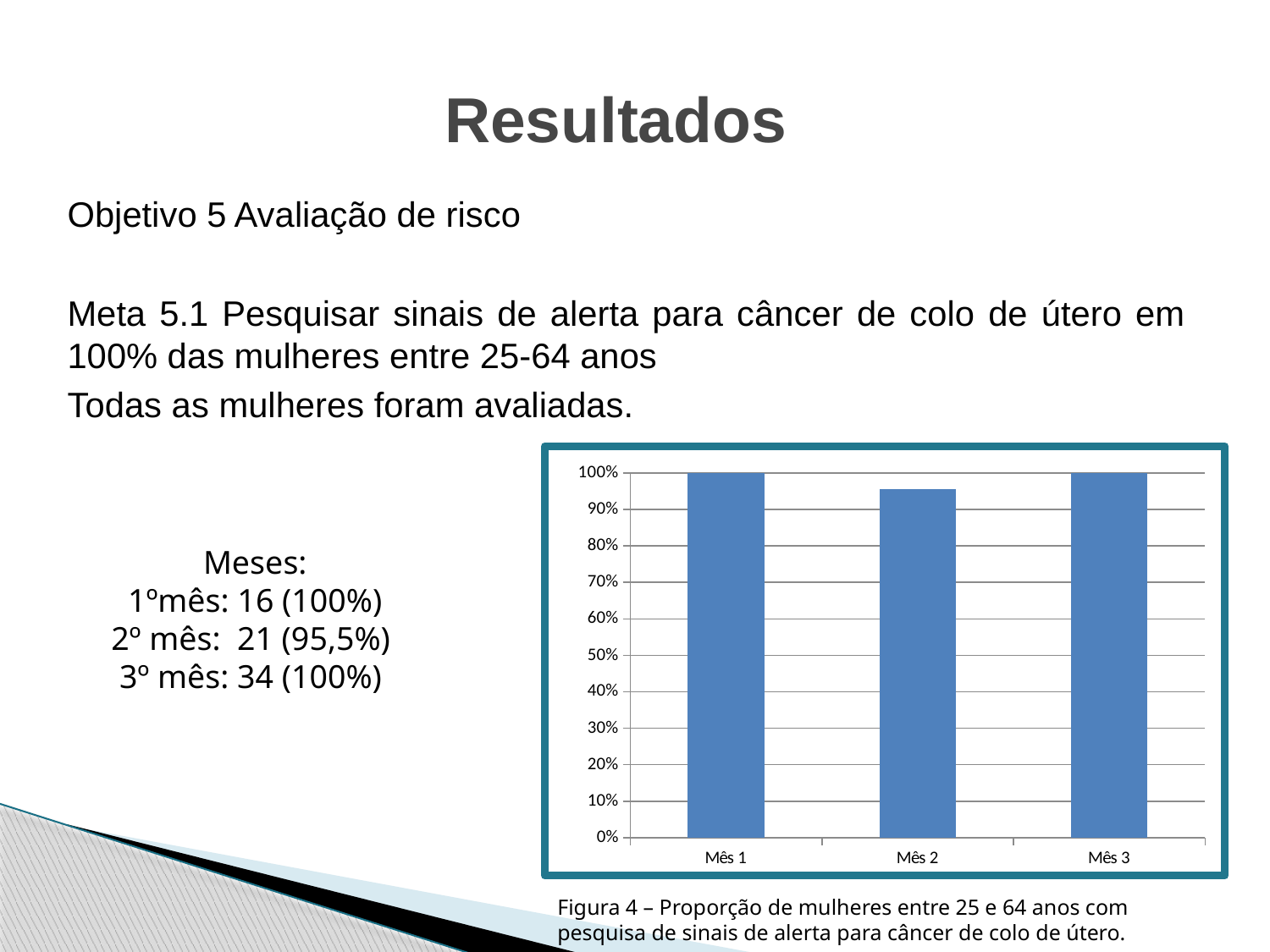
What colour are the bars in the chart? blue Which is larger, the value for Mês 2 or the value for Mês 3? Mês 3 Is the value for Mês 2 greater or less than 100%? less What is the highest tick shown on the y axis of the chart? 100% Is the value for Mês 2 greater or less than 90%? greater What is the value for Mês 3 in the chart? 100% Which month has the lowest value in the chart? Mês 2 What kind of chart is shown on the slide? bar chart How many categories are shown on the x axis of the chart? 3 Does the value rise or fall from Mês 2 to Mês 3? rise Which is larger, the value for Mês 1 or the value for Mês 2? Mês 1 What is the value for Mês 1 in the chart? 100%